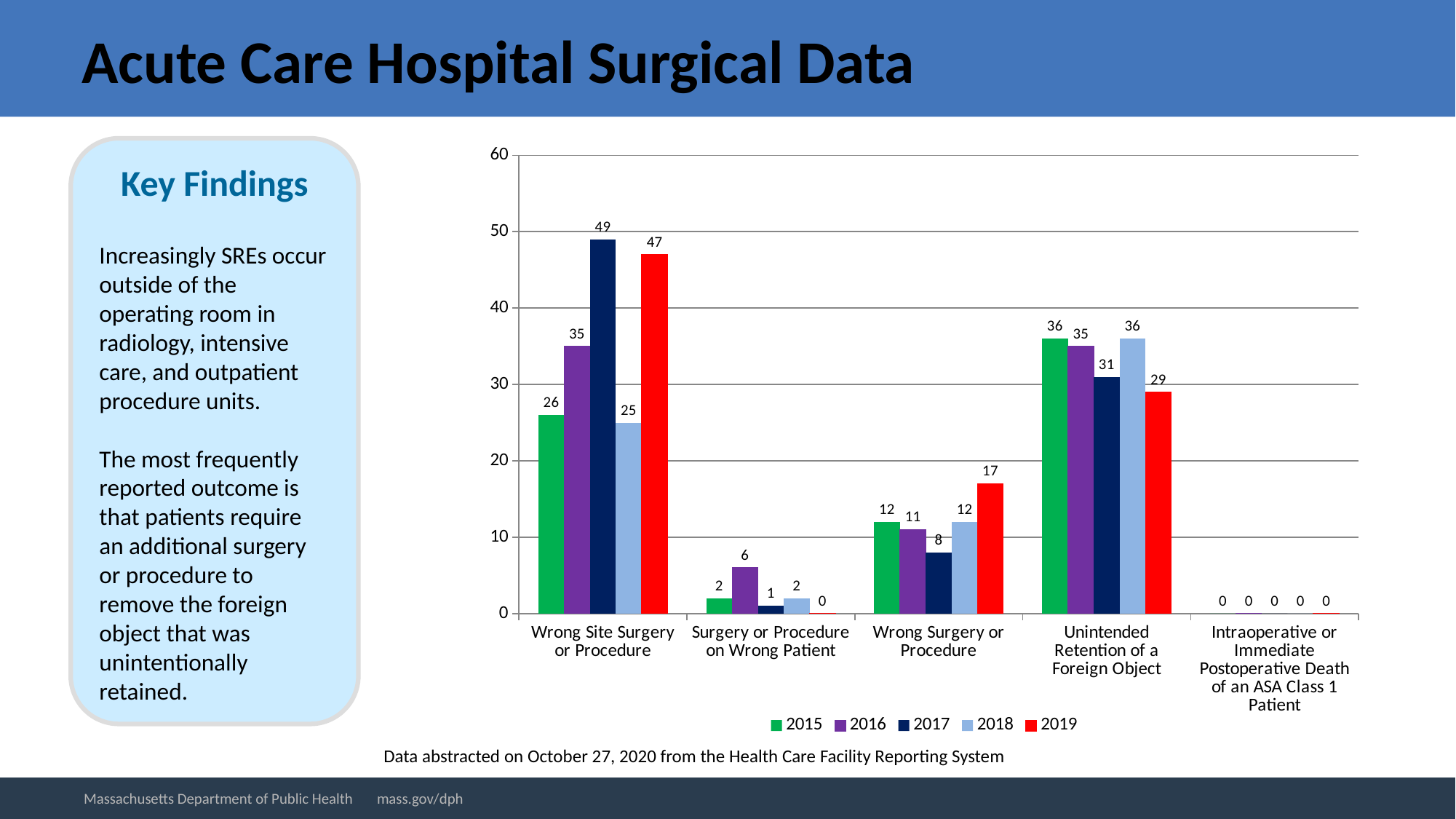
Which year has the lowest value for Wrong Site Surgery or Procedure? 2018 What is the value for Wrong Site Surgery or Procedure in 2017? 49 How many categories are shown on the x axis? 5 What is the difference between the 2017 and 2015 values for Wrong Site Surgery or Procedure? 23 What is the value for Surgery or Procedure on Wrong Patient in 2016? 6 Which is larger for Unintended Retention of a Foreign Object: the 2015 value or the 2017 value? 2015 What kind of chart is shown on the slide? bar chart How many series does the legend list? 5 Which colour represents 2019 in the legend? red Which year has the highest value for Wrong Surgery or Procedure? 2019 What is the value for Intraoperative or Immediate Postoperative Death of an ASA Class 1 Patient in 2018? 0 What is the value for Unintended Retention of a Foreign Object in 2019? 29